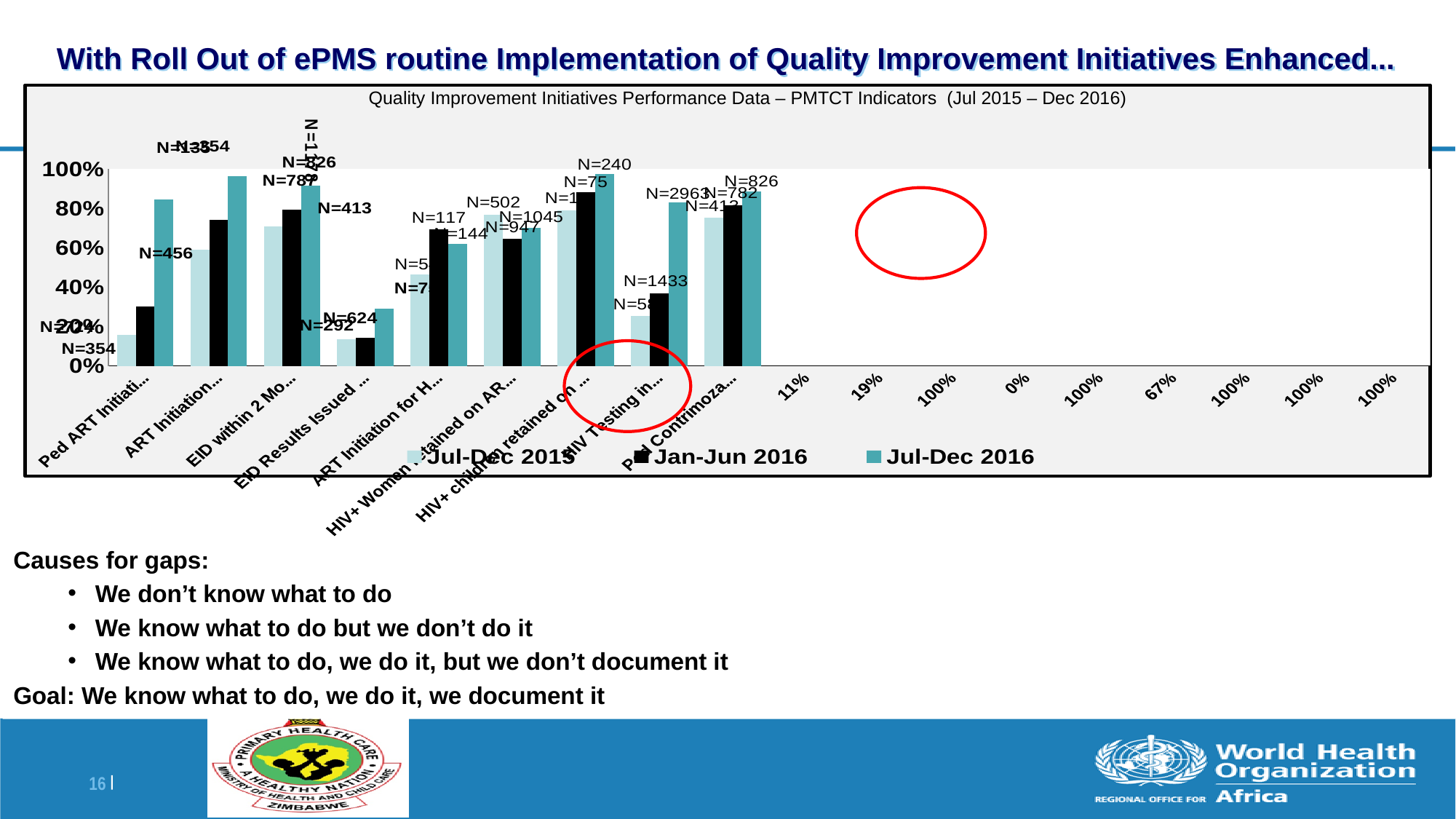
What is the title of the chart? Quality Improvement Initiatives Performance Data – PMTCT Indicators (Jul 2015 – Dec 2016) For the category 'HIV Testing in...', is the Jul-Dec 2016 value greater or less than 60%? greater Which series in the legend is shown in black? Jan-Jun 2016 For the first category (Ped ART Initiati...), which is larger: the Jul-Dec 2015 value or the Jul-Dec 2016 value? Jul-Dec 2016 For the category 'ART Initiation...', do the values rise or fall from Jul-Dec 2015 to Jul-Dec 2016? rise For the category 'EID Results Issued ...', is the Jan-Jun 2016 value greater or less than 40%? less For the category 'HIV Testing in...', which period has the highest value? Jul-Dec 2016 For the first category (Ped ART Initiati...), is the Jul-Dec 2015 value greater or less than 40%? less What kind of chart is shown on the slide? bar chart How many series does the chart legend list? 3